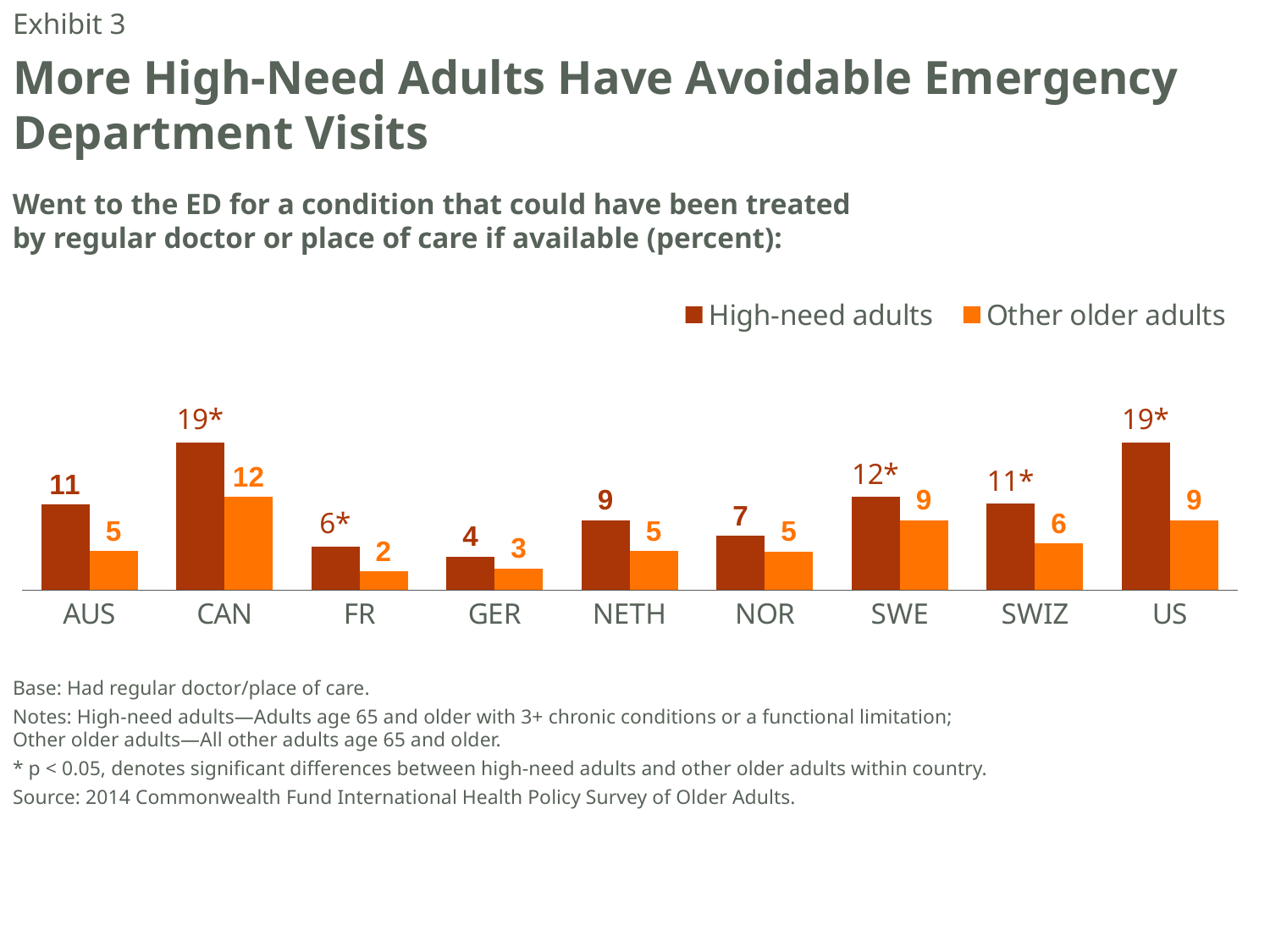
Which is larger in NETH: the value for High-need adults or for Other older adults? High-need adults What kind of chart is shown on the slide? Bar chart What is the value for High-need adults in GER? 4 Which country has the lowest value for High-need adults? GER How many countries are shown on the x axis? 9 Which country has the lowest value for Other older adults? FR What is the value for High-need adults in CAN? 19* What is the difference between High-need adults and Other older adults in AUS? 6 Which country has the highest value for Other older adults? CAN How many series does the legend list? 2 What is the value for Other older adults in SWE? 9 Which series is shown in orange in the legend? Other older adults